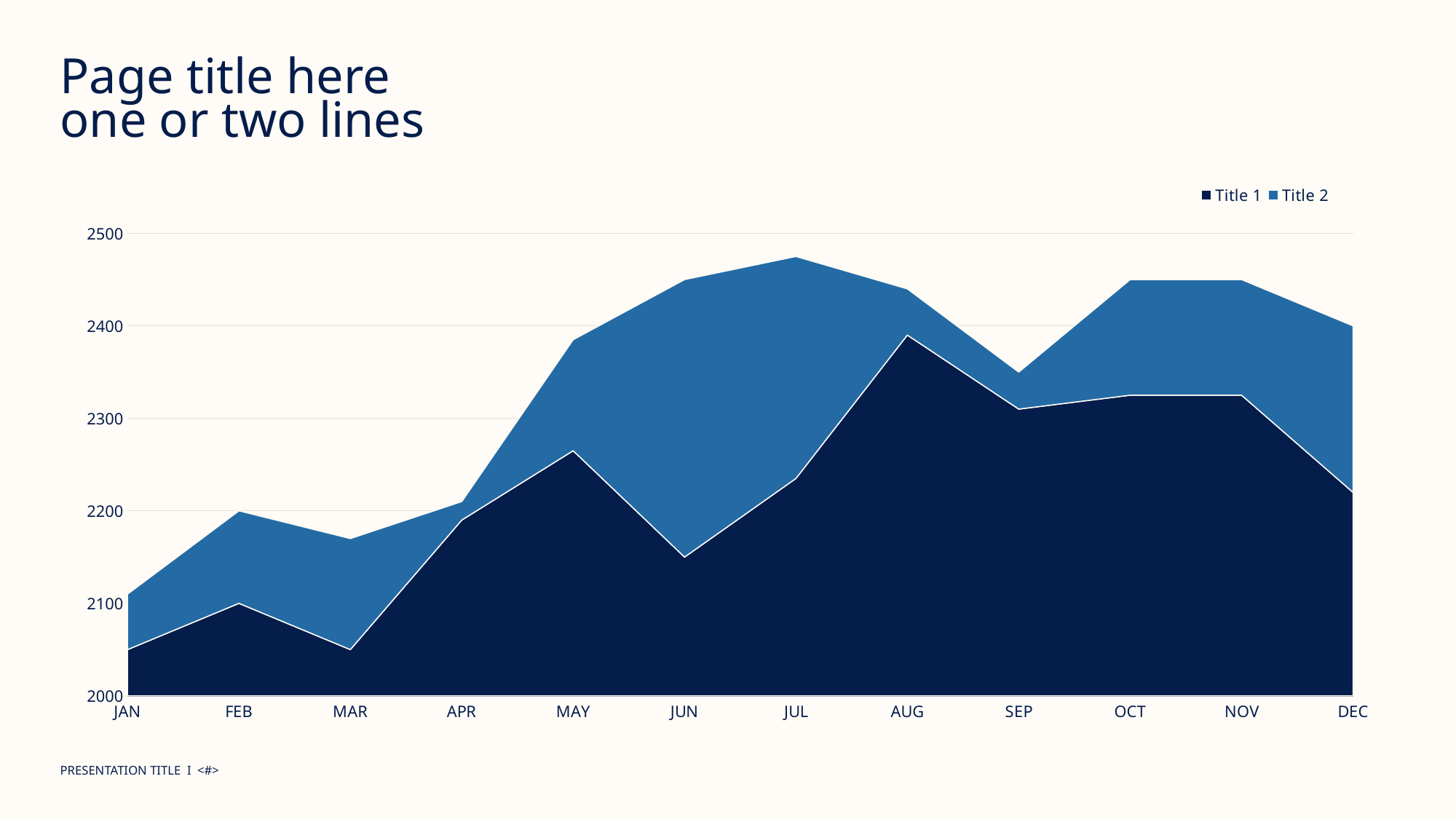
Is the value for Title 1 in MAR greater or less than 2100? less In which month is the top of the Title 2 area at its lowest? JAN How many months are shown along the x axis? 12 What kind of chart is shown on the slide? Area chart Is the value for Title 1 in OCT greater or less than 2300? greater Which is larger for Title 1: the value in FEB or the value in MAY? MAY Which series is drawn in the darker navy colour? Title 1 Does Title 1 rise or fall from JAN to MAY? rise What are the two series named in the legend? Title 1 and Title 2 Is the value for Title 1 in JUN greater or less than 2200? less How many series does the legend list? 2 In which month does Title 1 reach its highest value? AUG